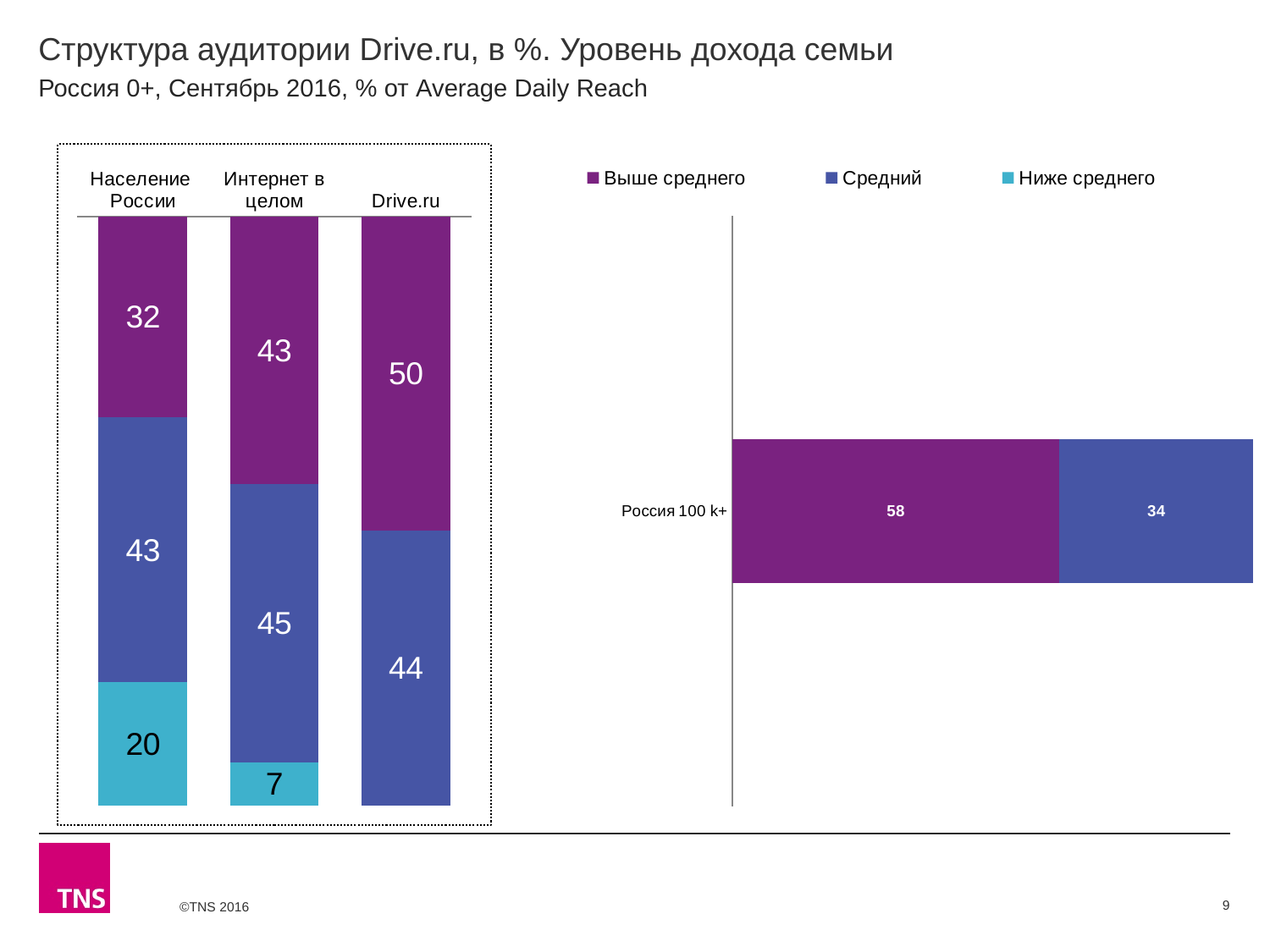
How many categories are shown on the x axis of the left chart? 3 In the left chart, what is the value of the 'Выше среднего' segment for Drive.ru? 50 In the right chart, what is the value of the 'Средний' segment for 'Россия 100 k+'? 34 In the left chart, what is the value of the 'Ниже среднего' segment for 'Население России'? 20 In the left chart, which is larger: the 'Ниже среднего' value for 'Население России' or for 'Интернет в целом'? Население России In the left chart, what is the difference between the 'Выше среднего' values for Drive.ru and 'Население России'? 18 In the left chart, which category has the lowest 'Ниже среднего' value among those with a labelled segment? Интернет в целом What type of chart is the right chart? Stacked bar chart In the left chart, which category has the highest 'Выше среднего' value? Drive.ru In the right chart, what is the value of the 'Выше среднего' segment for 'Россия 100 k+'? 58 In the left chart, what is the value of the 'Средний' segment for 'Интернет в целом'? 45 How many series does the legend list? 3